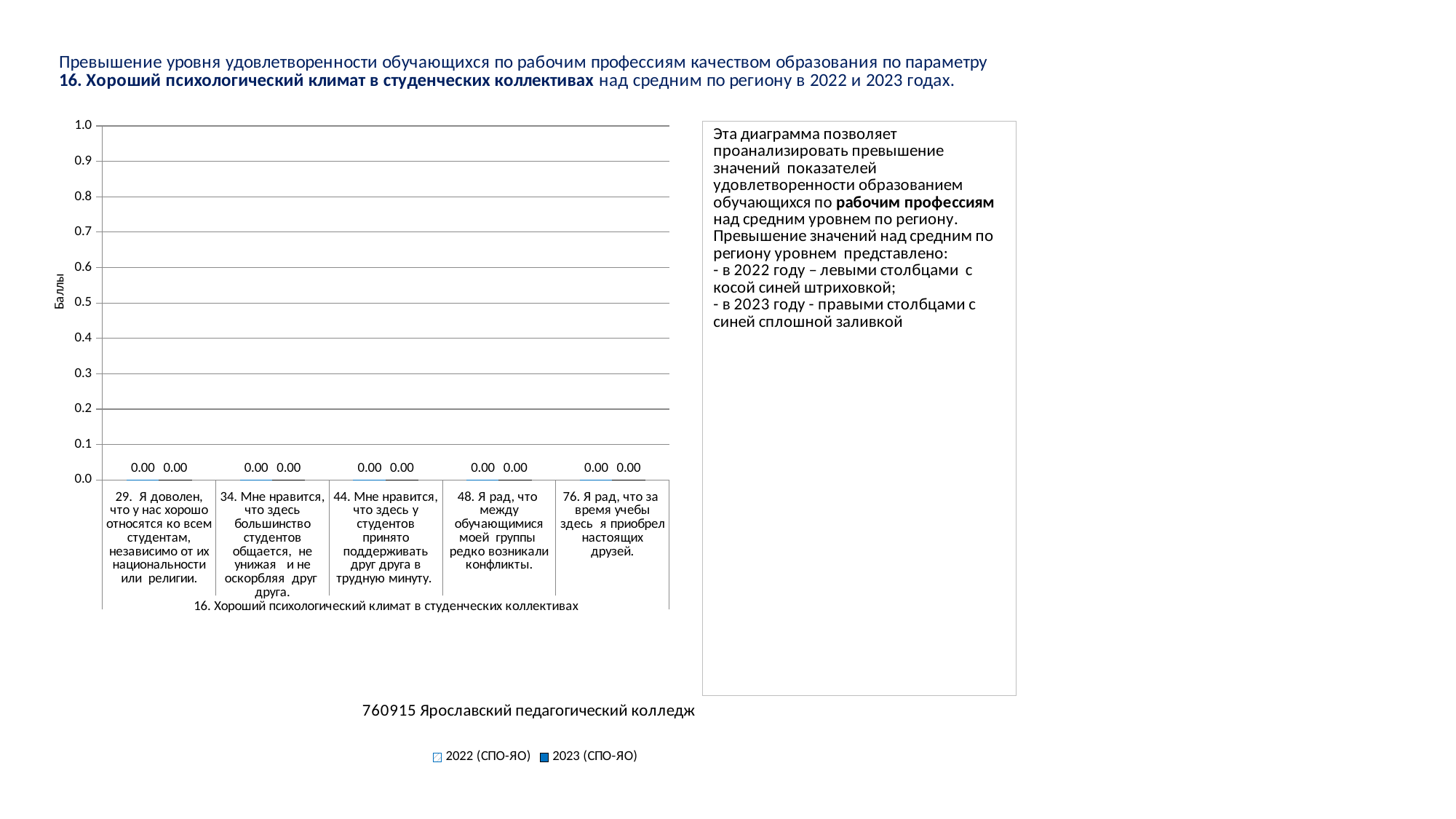
What is the label of the y axis of the chart? Баллы How many categories are shown on the x axis of the chart? 5 What is the difference between the 2022 (СПО-ЯО) and 2023 (СПО-ЯО) values for category 34? 0.00 What are the two series names listed in the legend? 2022 (СПО-ЯО) and 2023 (СПО-ЯО) What is the value for 2022 (СПО-ЯО) for category 29 (Я доволен, что у нас хорошо относятся ко всем студентам, независимо от их национальности или религии)? 0.00 How many series does the legend list? 2 What is the value for 2022 (СПО-ЯО) for category 48 (Я рад, что между обучающимися моей группы редко возникали конфликты)? 0.00 What is the value for 2023 (СПО-ЯО) for category 76 (Я рад, что за время учебы здесь я приобрел настоящих друзей)? 0.00 What kind of chart is shown on the slide? bar chart Do the 2022 (СПО-ЯО) values rise, fall, or stay flat across the categories on the x axis? stay flat What is the value for 2023 (СПО-ЯО) for category 44 (Мне нравится, что здесь у студентов принято поддерживать друг друга в трудную минуту)? 0.00 Is the value for 2023 (СПО-ЯО) for category 29 greater or less than 0.1? less